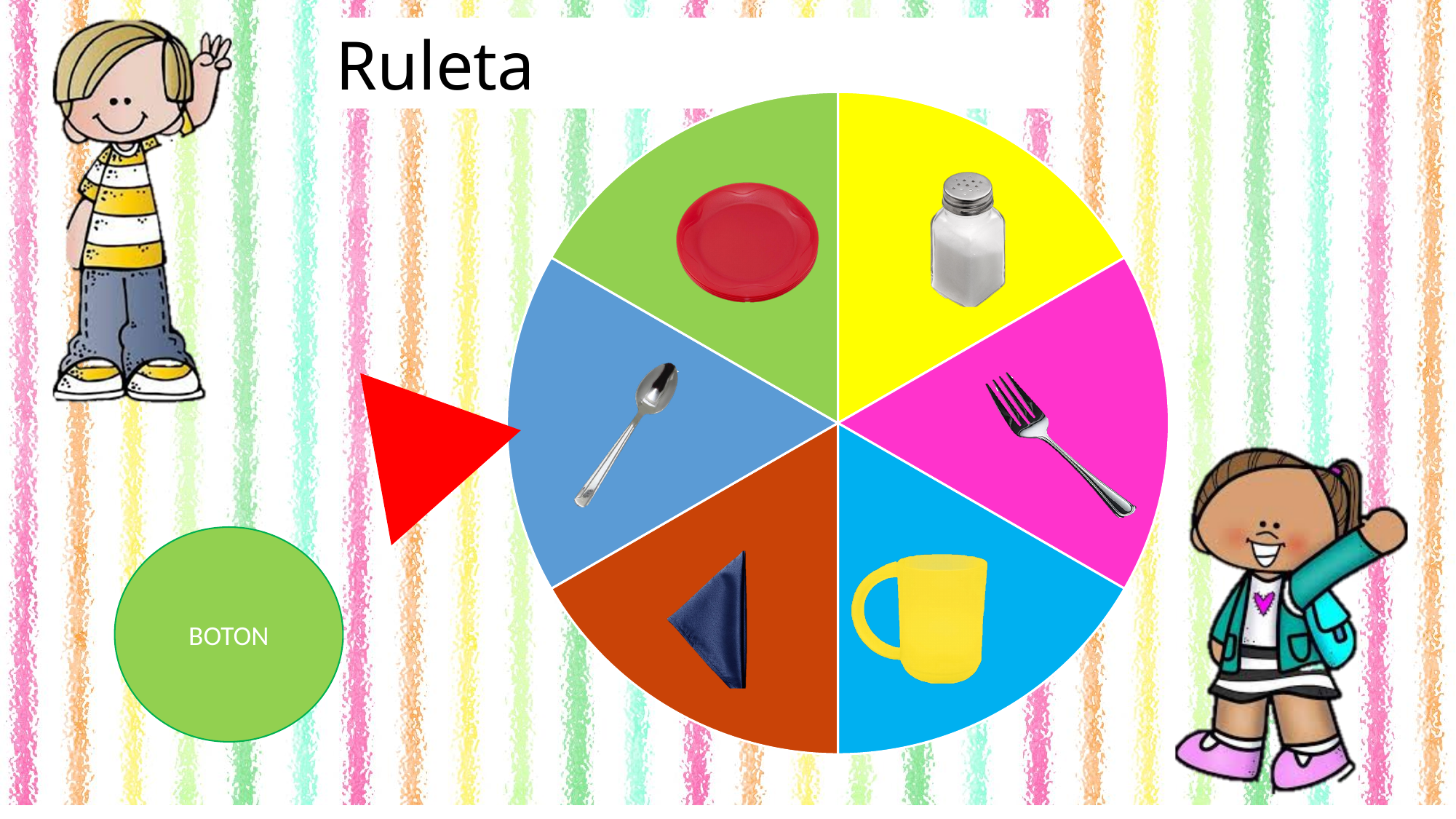
Which item is pictured in the light blue slice at the bottom right? a yellow cup Which item is pictured in the blue slice that the red arrow points to? a spoon What kind of chart is the Ruleta wheel on the slide? pie chart What text is written on the green circle at the bottom left of the slide? BOTON What is the title shown above the pie chart? Ruleta What colour is the slice containing the fork? pink Which item is pictured in the green slice? a red plate How many slices does the Ruleta pie chart have? 6 Which item is pictured in the brown slice? a napkin What colour is the slice containing the salt shaker? yellow